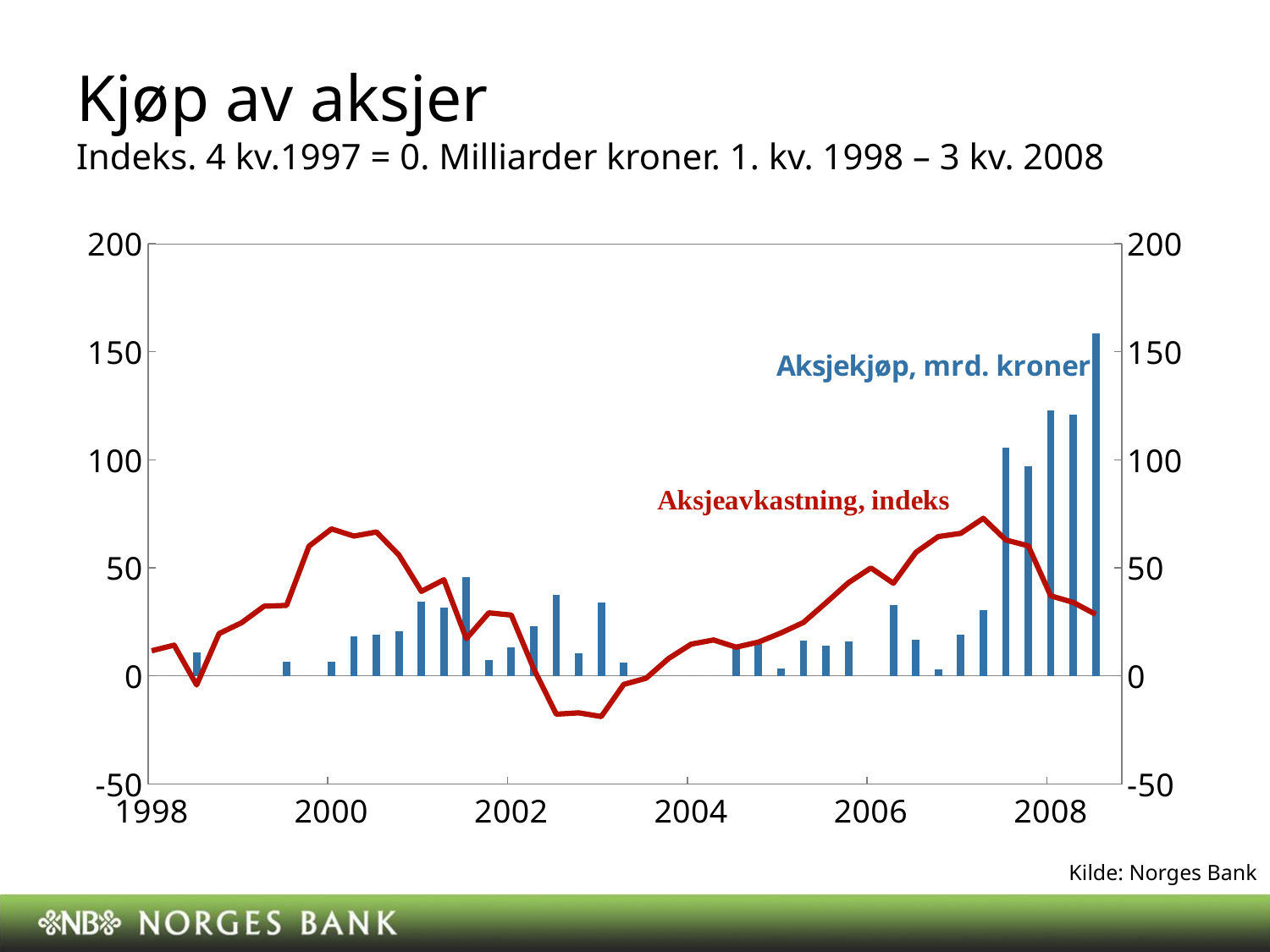
Which series is drawn as bars on the chart? Aksjekjøp, mrd. kroner Does the Aksjeavkastning, indeks line rise or fall between 2004 and 2007? rise What kind of chart is shown on the slide? A combined bar and line chart What is the source given for the chart? Norges Bank In which year does the tallest bar for Aksjekjøp, mrd. kroner occur? 2008 Is the value of the Aksjeavkastning, indeks line in late 2002 greater or less than 0? less Is the value of the Aksjeavkastning, indeks line at the start of 2000 greater or less than 50? greater Which is larger: the Aksjekjøp bar in 2008 or the Aksjekjøp bar in 2004? 2008 What is the title of the chart on the slide? Kjøp av aksjer Does the Aksjeavkastning, indeks line rise or fall from 2007 to the end of the series in 2008? fall How many data series are plotted on the chart? 2 Is the tallest bar for Aksjekjøp, mrd. kroner greater or less than 150? greater